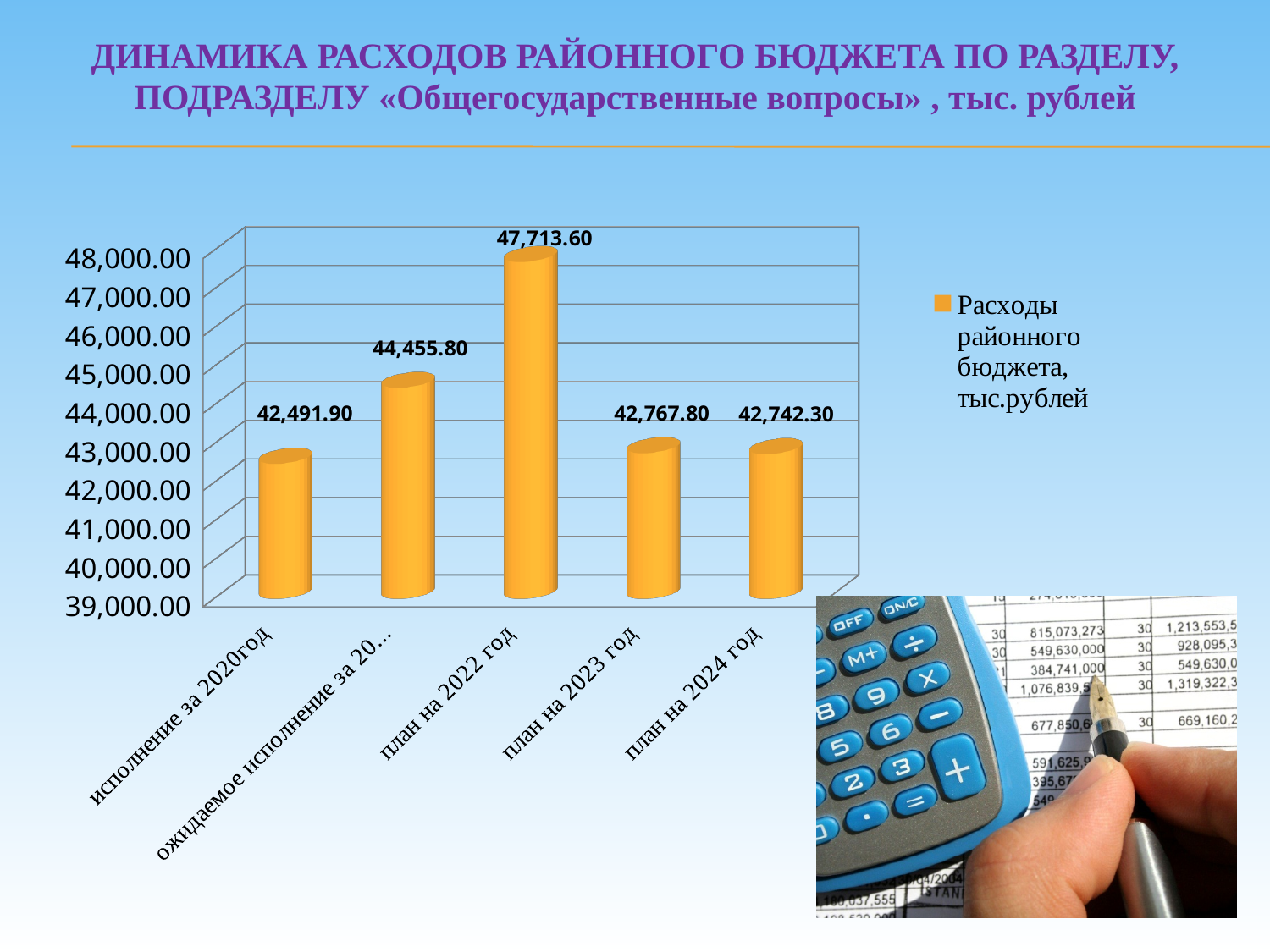
What is the value for исполнение за 2020год? 42,491.90 Which category has the lowest value? исполнение за 2020год What kind of chart is shown on the slide? bar chart Which is larger, план на 2023 год or план на 2024 год? план на 2023 год How many bars are shown in the chart? 5 What is the value for план на 2022 год? 47,713.60 What is the value for план на 2023 год? 42,767.80 Which category has the highest value? план на 2022 год What is the value for план на 2024 год? 42,742.30 What is the difference between план на 2022 год and исполнение за 2020год? 5,221.70 What is the value of the second bar from the left? 44,455.80 What series name does the legend show? Расходы районного бюджета, тыс.рублей